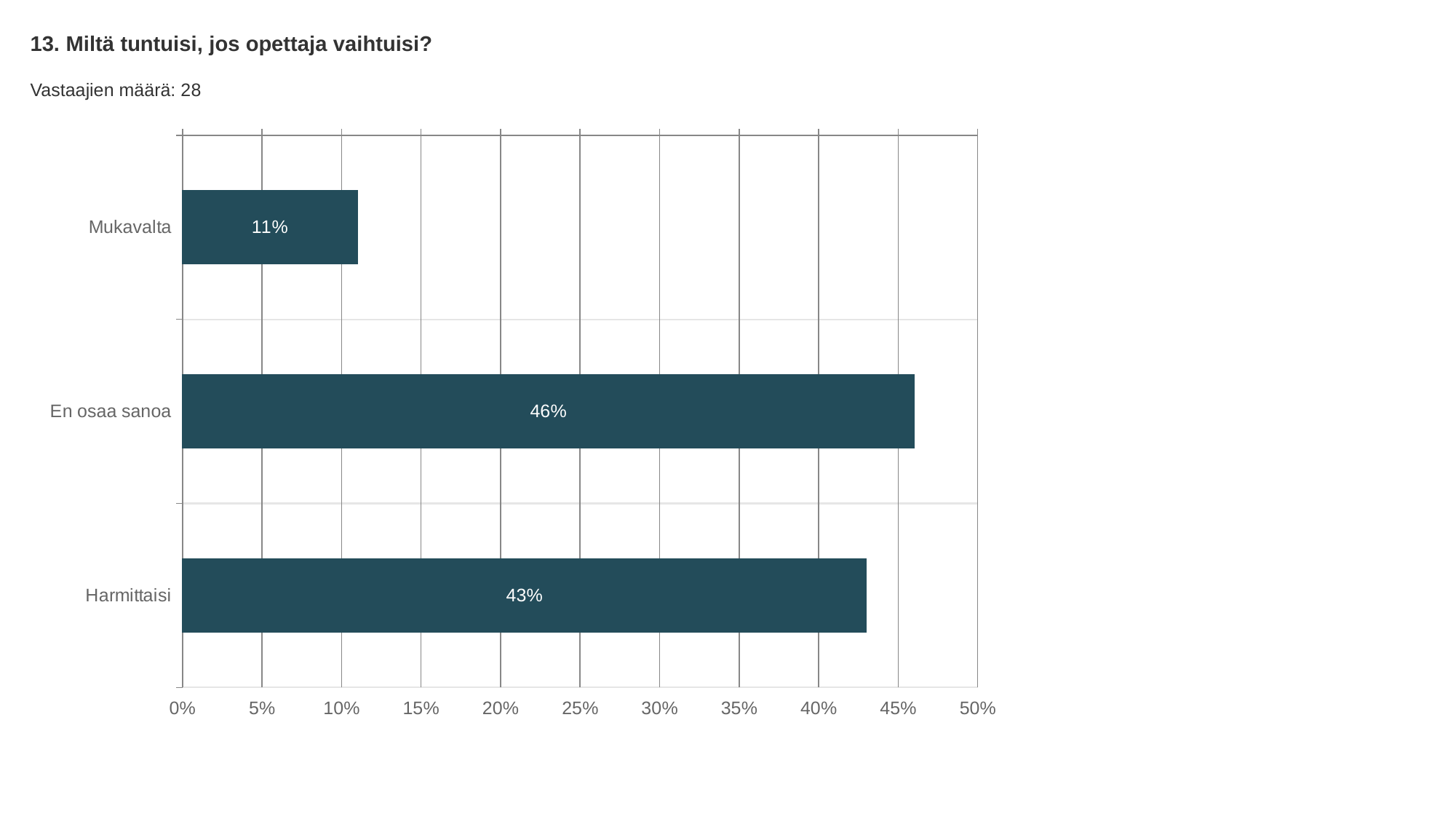
Which category has the lowest value? Mukavalta Is the value for En osaa sanoa greater or less than 40%? greater What is the value for En osaa sanoa? 46% How many respondents (Vastaajien määrä) are reported on the slide? 28 What is the difference between the values for Harmittaisi and Mukavalta? 32% Which is larger, the value for Harmittaisi or the value for Mukavalta? Harmittaisi What is the value for Mukavalta? 11% What is the value for Harmittaisi? 43% How many categories are shown in the chart? 3 Which category has the highest value? En osaa sanoa What kind of chart is shown on the slide? bar chart What is the difference between the values for En osaa sanoa and Harmittaisi? 3%